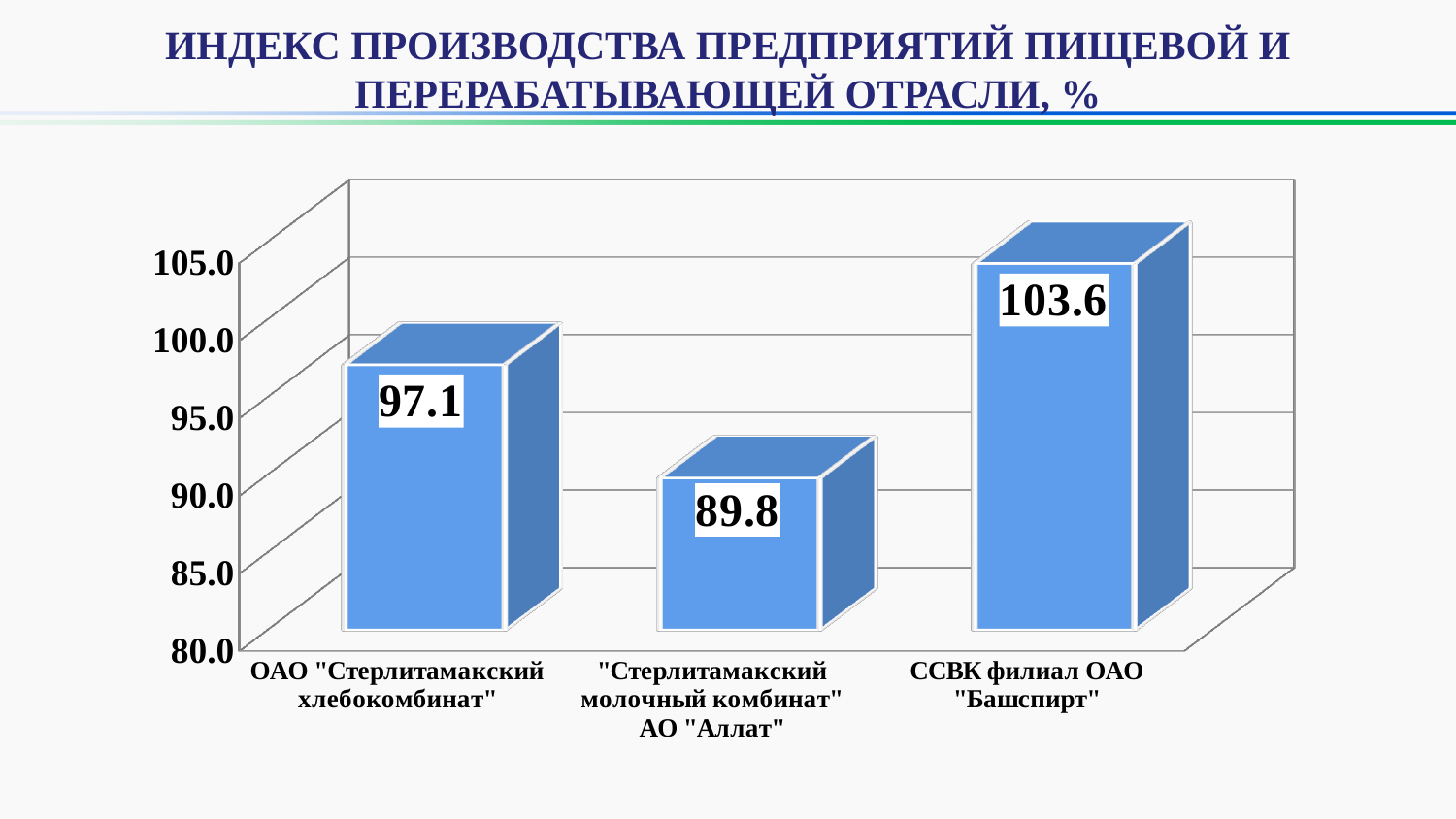
What is the title of the chart? ИНДЕКС ПРОИЗВОДСТВА ПРЕДПРИЯТИЙ ПИЩЕВОЙ И ПЕРЕРАБАТЫВАЮЩЕЙ ОТРАСЛИ, % What kind of chart is shown on the slide? bar chart Is the value for ССВК филиал ОАО "Башспирт" greater or less than 100.0? greater Which has a higher production index: ОАО "Стерлитамакский хлебокомбинат" or "Стерлитамакский молочный комбинат" АО "Аллат"? ОАО "Стерлитамакский хлебокомбинат" Which enterprise has the highest production index? ССВК филиал ОАО "Башспирт" What is the difference between the production index of ССВК филиал ОАО "Башспирт" and ОАО "Стерлитамакский хлебокомбинат"? 6.5 What is the production index value for ССВК филиал ОАО "Башспирт"? 103.6 Which enterprise has the lowest production index? "Стерлитамакский молочный комбинат" АО "Аллат" What is the production index value for "Стерлитамакский молочный комбинат" АО "Аллат"? 89.8 What is the difference between the production index of ОАО "Стерлитамакский хлебокомбинат" and "Стерлитамакский молочный комбинат" АО "Аллат"? 7.3 How many enterprises are shown in the chart? 3 What is the production index value for ОАО "Стерлитамакский хлебокомбинат"? 97.1